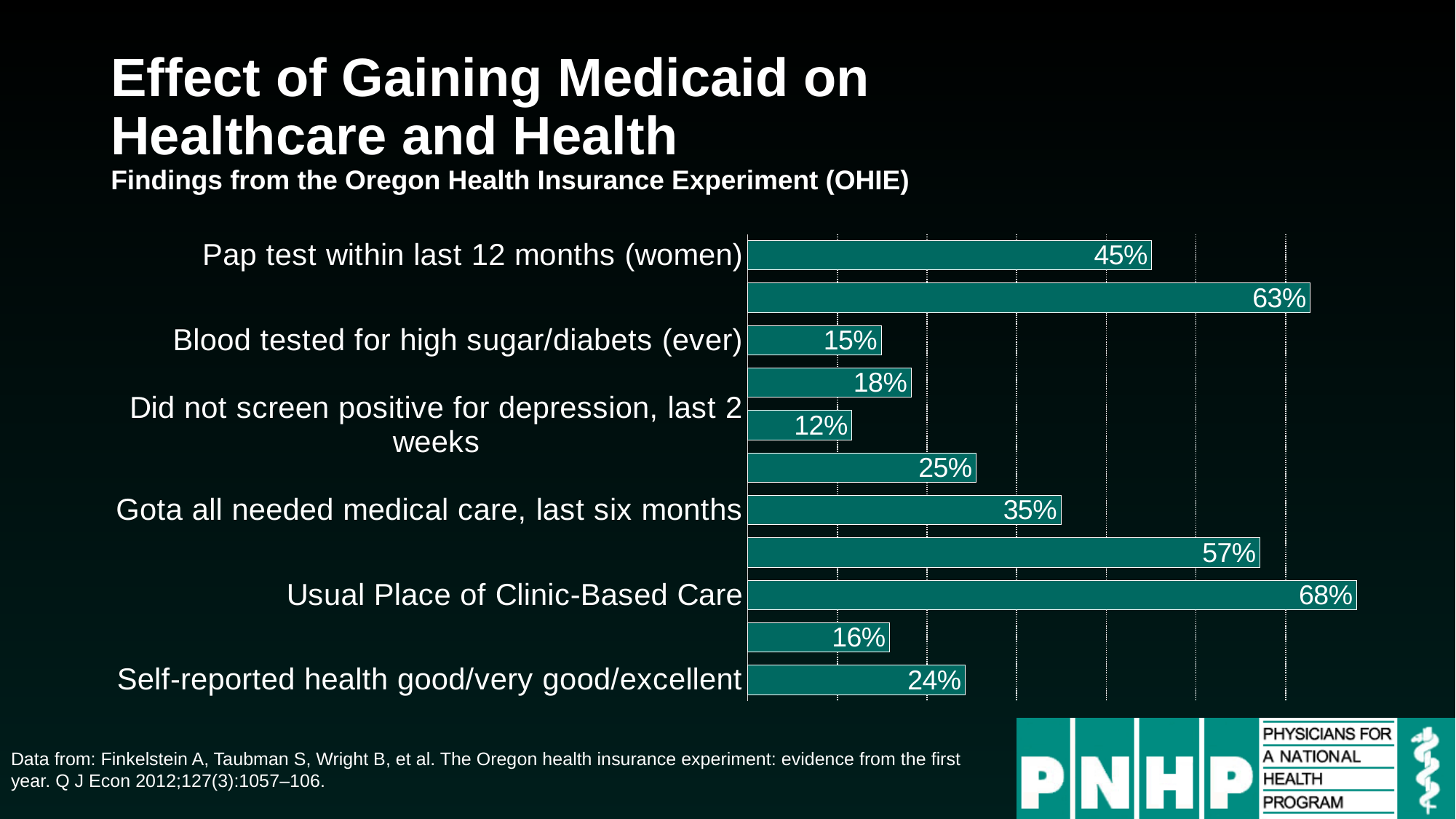
What kind of chart is shown on the slide? Bar chart What is the value for "Usual Place of Clinic-Based Care"? 68% What is the value for "Blood tested for high sugar/diabets (ever)"? 15% What is the value for "Self-reported health good/very good/excellent"? 24% Which is larger, the value for "Gota all needed medical care, last six months" or the value for "Self-reported health good/very good/excellent"? Gota all needed medical care, last six months How many bars are plotted in the chart? 11 What is the value for "Gota all needed medical care, last six months"? 35% What is the value for "Did not screen positive for depression, last 2 weeks"? 12% What is the difference between the values for "Usual Place of Clinic-Based Care" and "Pap test within last 12 months (women)"? 23% What is the value for "Pap test within last 12 months (women)"? 45% Which labeled category has the lowest value? Did not screen positive for depression, last 2 weeks Which labeled category has the highest value? Usual Place of Clinic-Based Care